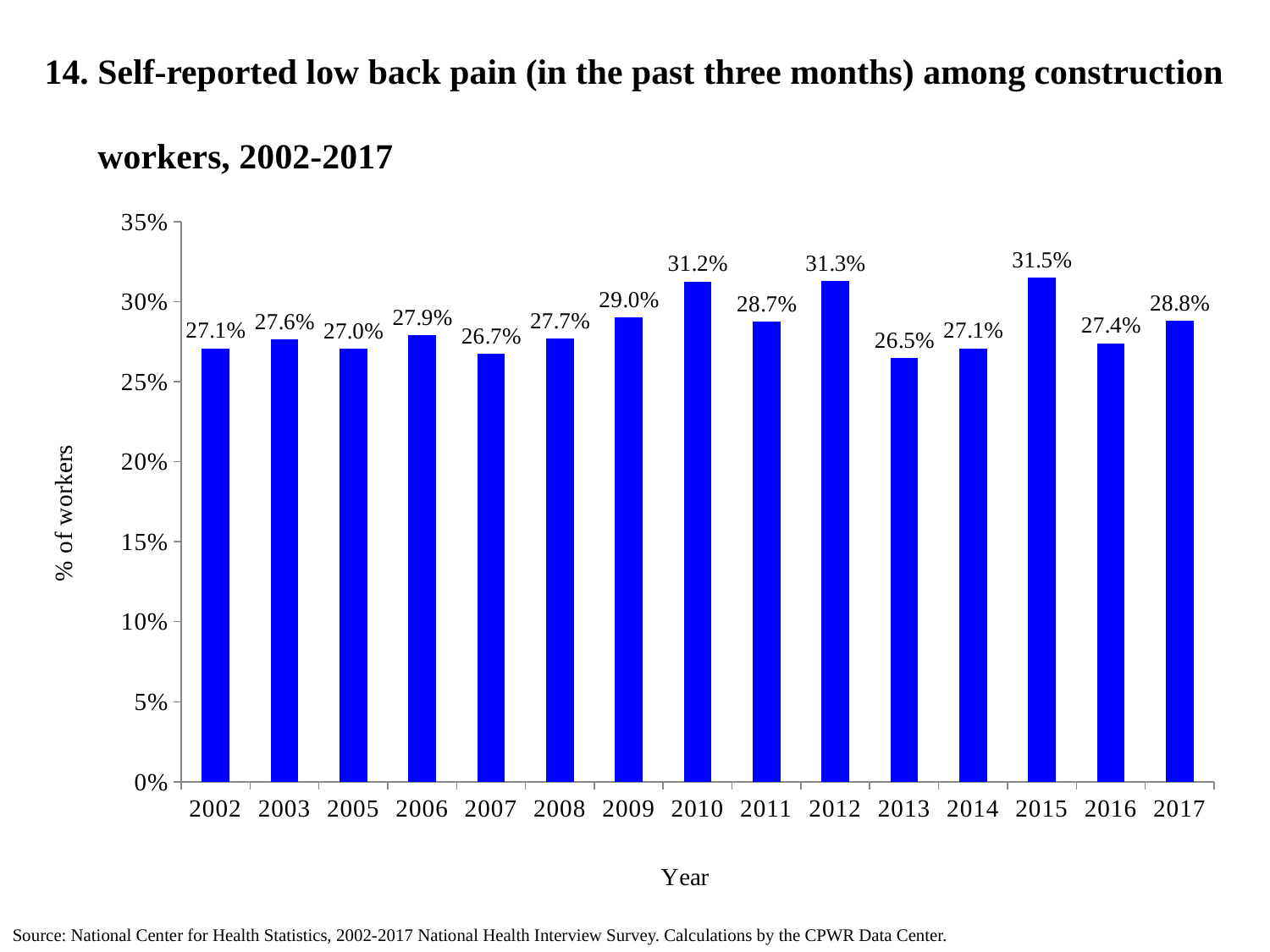
What is the value shown for 2017? 28.8% What is the value shown for 2013? 26.5% What is the difference between the values for 2012 and 2011? 2.6% What kind of chart is shown on the slide? Bar chart What percentage of construction workers self-reported low back pain in 2010? 31.2% What is the label of the y axis? % of workers Which year has the lowest percentage of workers reporting low back pain? 2013 What is the difference between the values for 2015 and 2013? 5.0% How many years are shown on the x axis? 15 Which year has the highest percentage of workers reporting low back pain? 2015 Which year has a higher value, 2009 or 2016? 2009 Is the value for 2007 greater or less than 30%? less